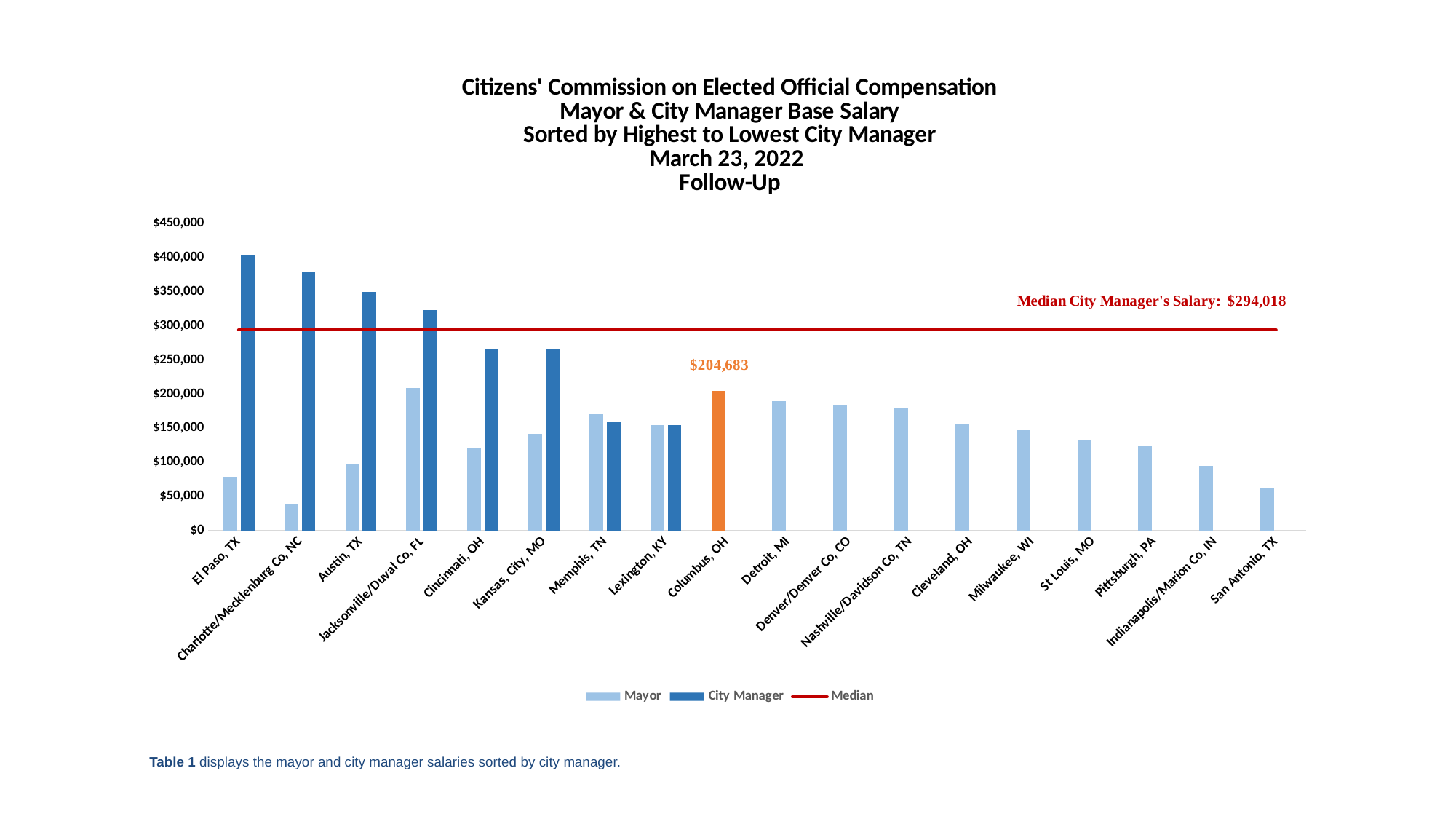
How many entries does the legend list? 3 Is the Mayor salary for San Antonio, TX greater or less than $50,000? greater Which is larger, the Mayor salary for Detroit, MI or for Pittsburgh, PA? Detroit, MI Which is larger, the City Manager salary for El Paso, TX or for Austin, TX? El Paso, TX Which city has the highest City Manager salary? El Paso, TX Is the City Manager salary for Charlotte/Mecklenburg Co, NC greater or less than $350,000? greater Which city has the lowest Mayor salary? Charlotte/Mecklenburg Co, NC What is the Median City Manager's Salary shown on the chart? $294,018 Is the Mayor salary for Detroit, MI greater or less than $200,000? less What kind of chart is this? Combination bar and line chart (bars for Mayor and City Manager salaries with a median line) How many cities are shown on the x axis? 18 What is the value printed on the orange bar for Columbus, OH? $204,683